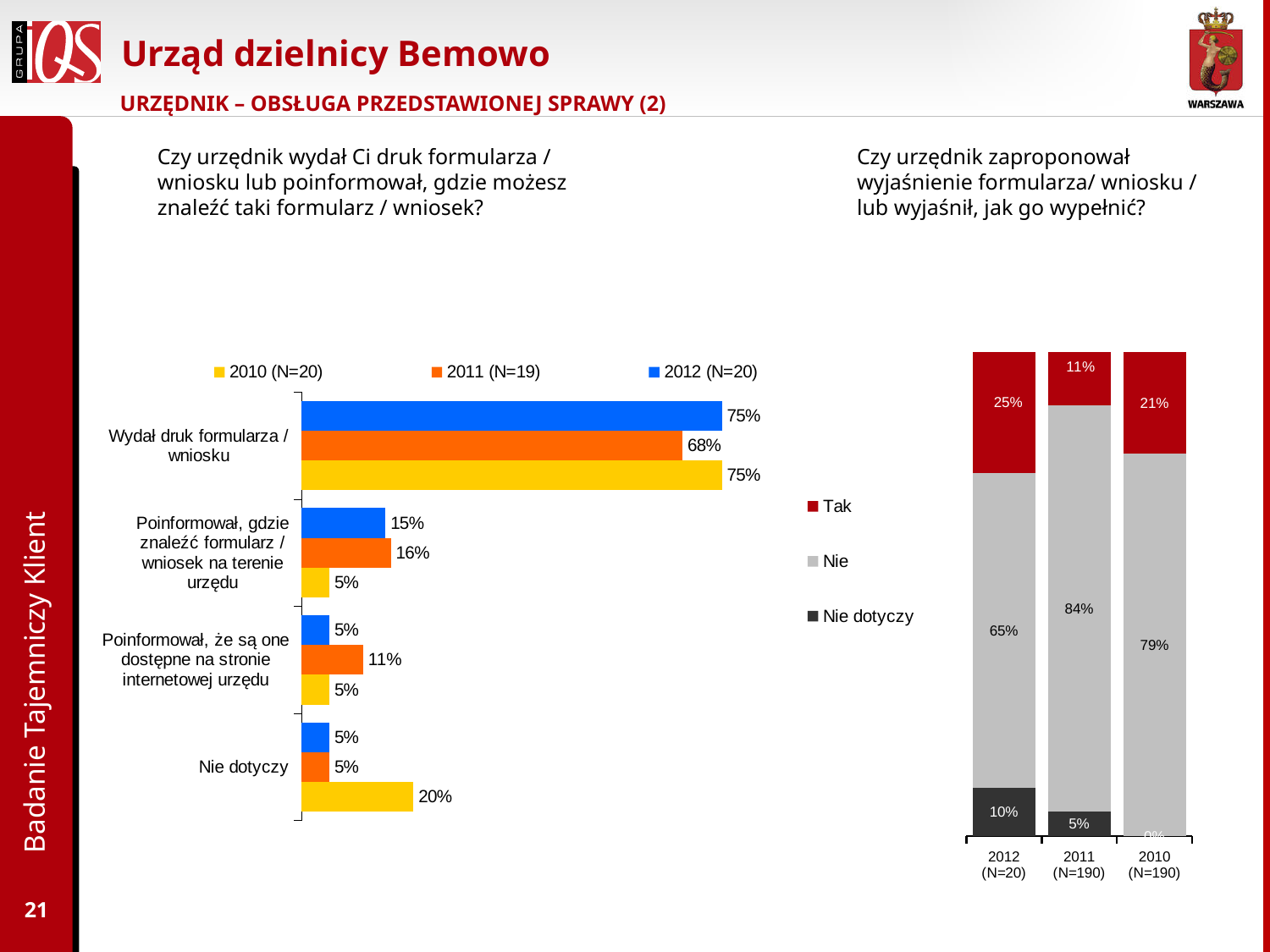
In the right stacked chart, what is the 'Tak' value for 2012 (N=20)? 25% In the right stacked chart, what is the 'Nie' value for 2011 (N=190)? 84% In the right stacked chart, which year has the highest 'Tak' value? 2012 (N=20) In the left chart, what is the 2011 (N=19) value for 'Wydał druk formularza / wniosku'? 68% In the left chart, how many series does the legend list? 3 In the left chart, which category has the highest 2012 (N=20) value? Wydał druk formularza / wniosku In the left chart, what is the 2010 (N=20) value for 'Nie dotyczy'? 20% What type of chart is the chart on the left? Bar chart In the left chart, what is the difference between the 2011 and 2010 values for 'Poinformował, że są one dostępne na stronie internetowej urzędu'? 6% In the left chart, what is the 2012 (N=20) value for 'Poinformował, gdzie znaleźć formularz / wniosek na terenie urzędu'? 15% In the left chart, how many categories are shown? 4 In the right stacked chart, is the 'Tak' value for 2010 (N=190) larger or smaller than the 'Tak' value for 2011 (N=190)? Larger